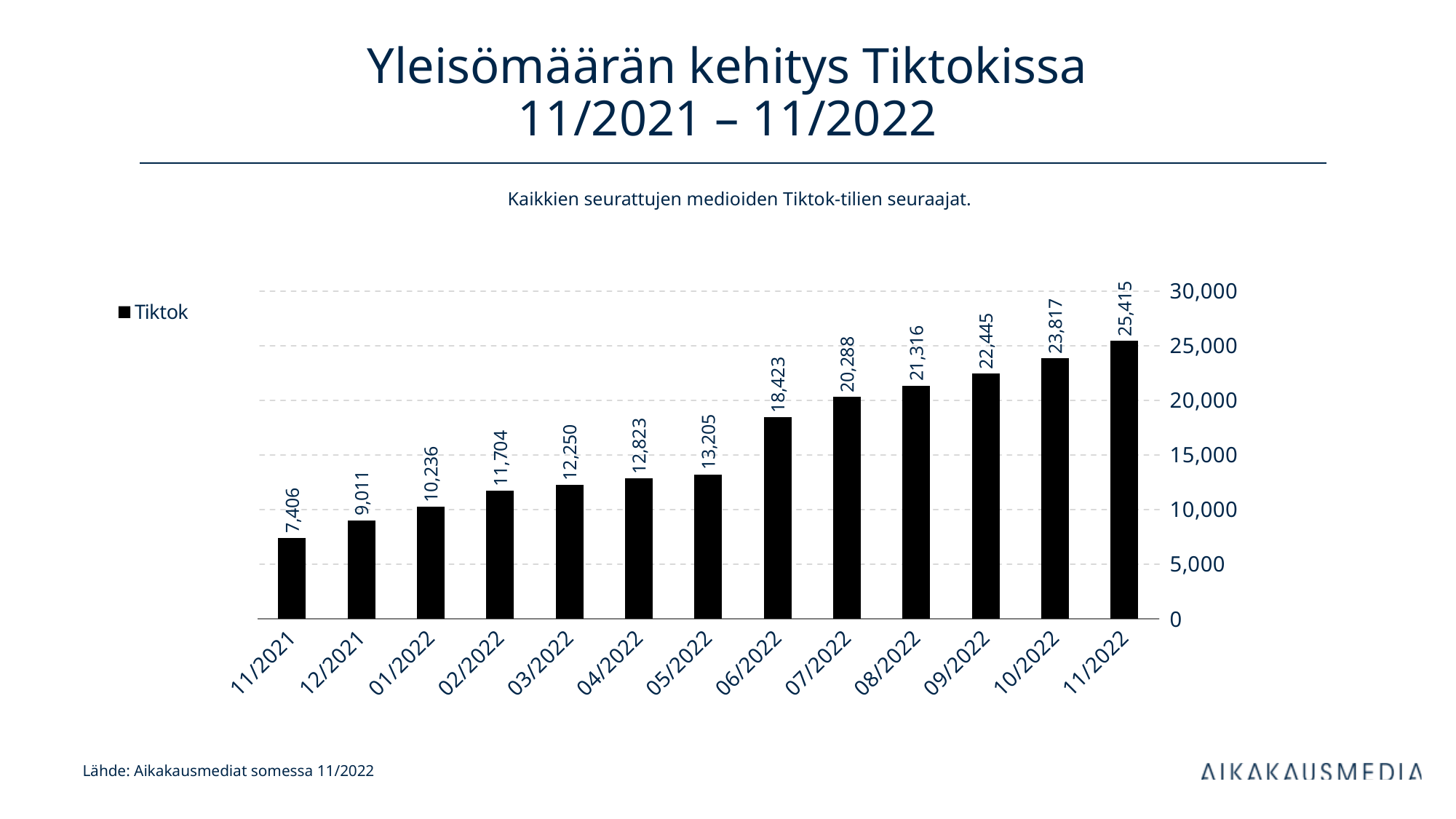
How many months are shown on the x axis? 13 What is the difference between the values for 06/2022 and 05/2022? 5,218 What is the difference between the values for 11/2022 and 11/2021? 18,009 Which month has the highest value? 11/2022 Is the value for 07/2022 greater or less than 20,000? greater Which is larger, the value for 03/2022 or the value for 04/2022? 04/2022 What kind of chart is shown on the slide? bar chart What is the value for 11/2022? 25,415 What is the value for 06/2022? 18,423 Which month has the lowest value? 11/2021 Do the values rise or fall from 11/2021 to 11/2022? rise What is the value for 11/2021? 7,406